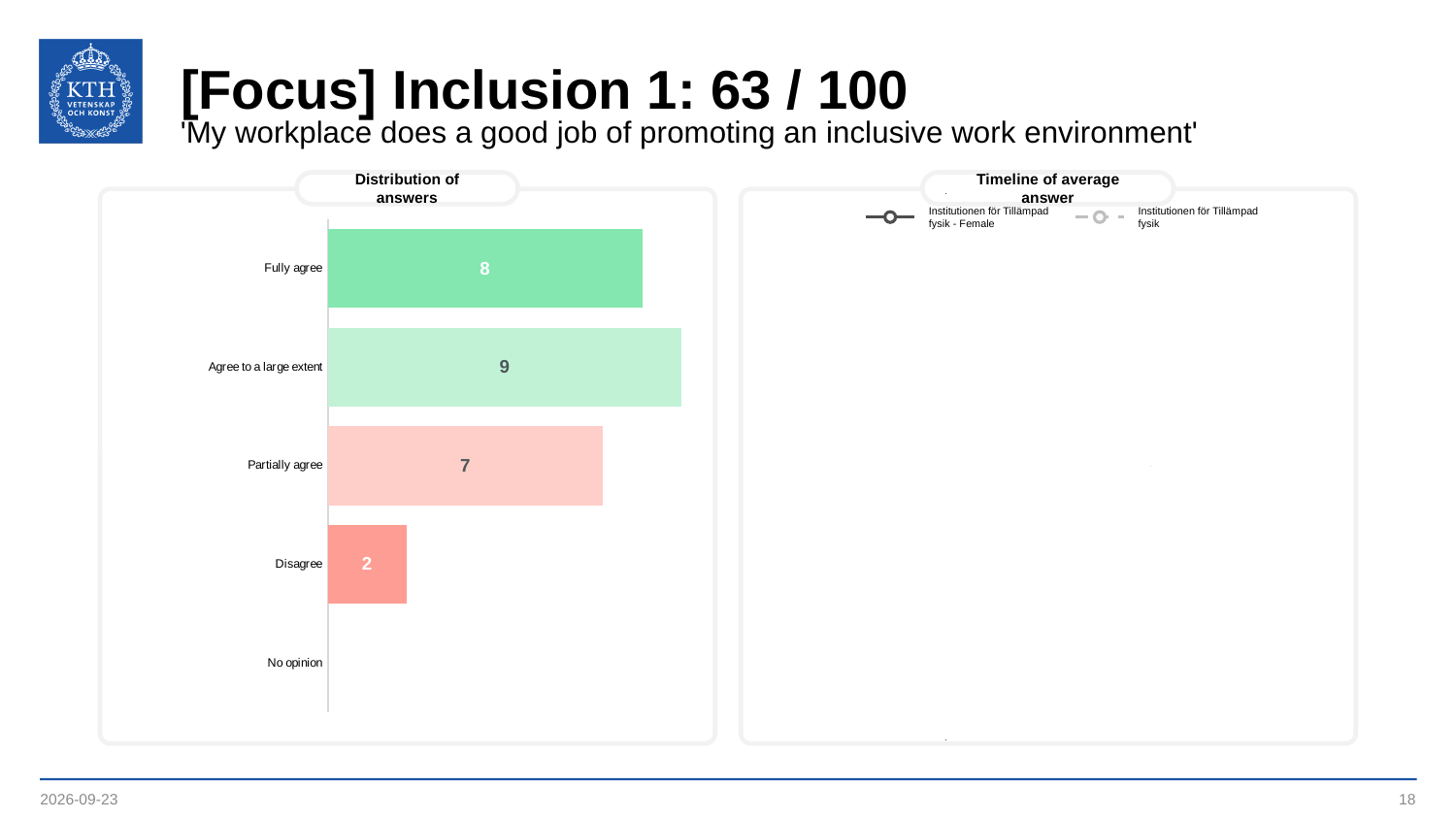
In the 'Distribution of answers' chart, what is the total of the 'Fully agree' and 'Agree to a large extent' bars combined? 17 In the 'Distribution of answers' chart, how many answer categories are listed on the axis? 5 In the 'Timeline of average answer' chart, how many series does the legend list? 2 In the 'Distribution of answers' chart, which answer category with a visible bar has the lowest value? Disagree In the 'Distribution of answers' chart, which answer category has the highest value? Agree to a large extent In the 'Distribution of answers' chart, which is larger: 'Fully agree' or 'Partially agree'? Fully agree In the 'Distribution of answers' chart, what is the difference between 'Agree to a large extent' and 'Disagree'? 7 In the 'Distribution of answers' chart, what is the value for 'Agree to a large extent'? 9 In the 'Distribution of answers' chart, what is the value for 'Disagree'? 2 What kind of chart is the 'Distribution of answers' chart? Bar chart In the 'Distribution of answers' chart, how many respondents chose 'Fully agree'? 8 In the 'Distribution of answers' chart, what is the value for 'Partially agree'? 7